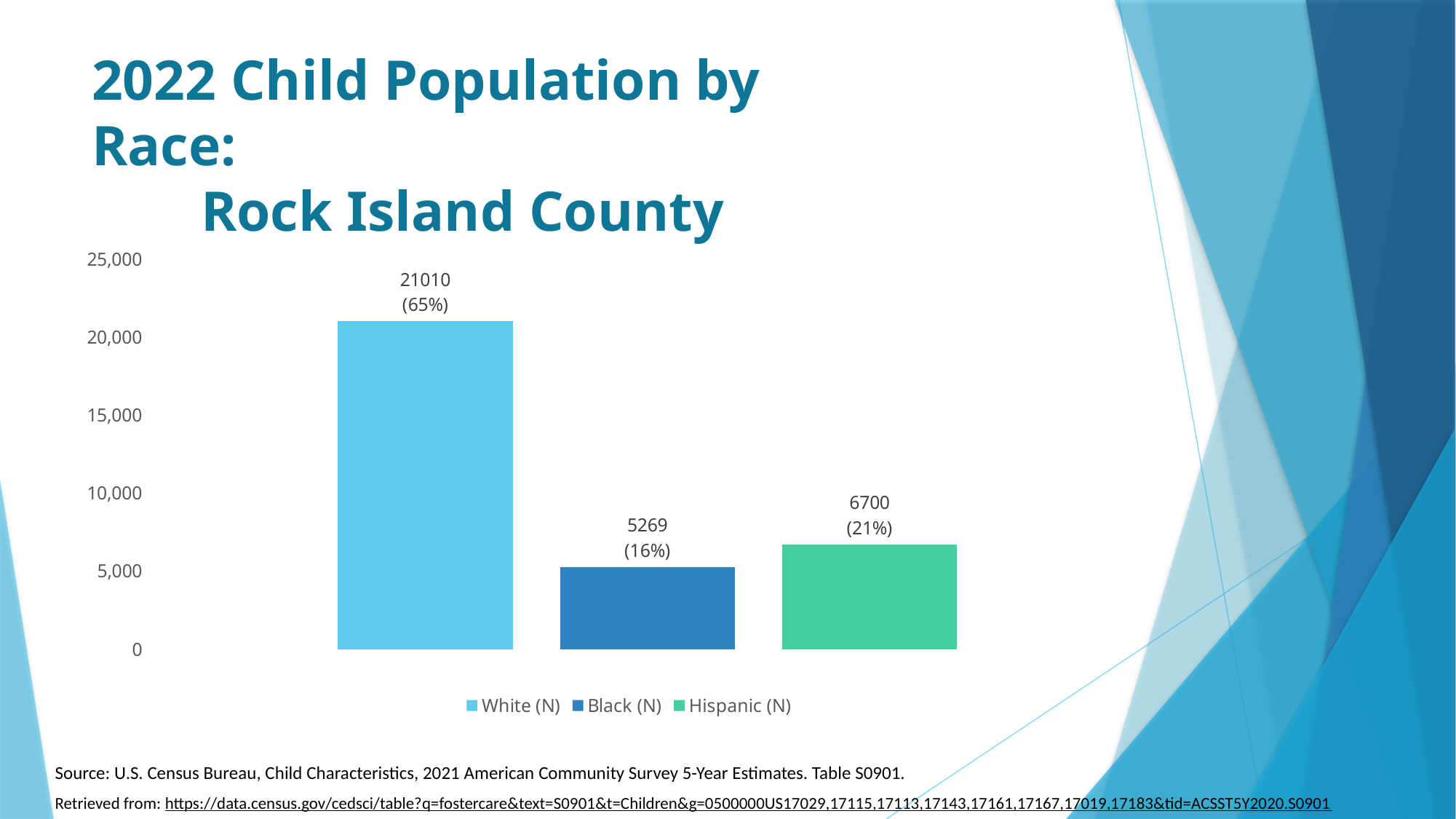
Which is larger, the value for Black (N) or Hispanic (N)? Hispanic (N) What is the difference between the White (N) and Hispanic (N) values? 14310 What is the value for White (N)? 21010 Which group has the highest child population? White (N) Is the value for White (N) greater or less than 20,000? greater What is the value for Black (N)? 5269 What kind of chart is shown on the slide? Bar chart What is the value for Hispanic (N)? 6700 How many series does the legend list? 3 Which group has the lowest child population? Black (N) What percentage is shown for Hispanic (N)? 21% What is the difference between the Hispanic (N) and Black (N) values? 1431